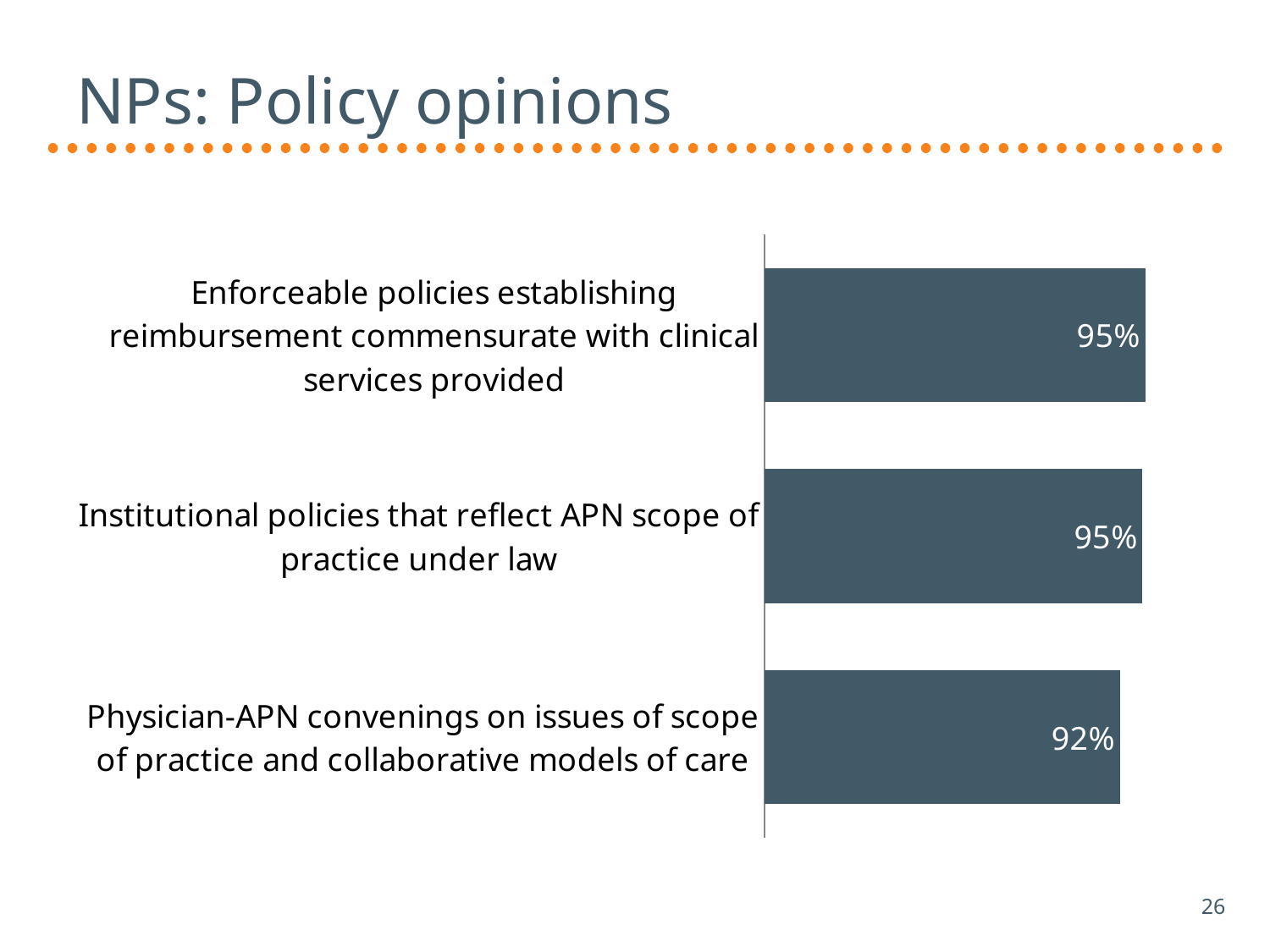
Are the bars on the chart horizontal or vertical? Horizontal What is the value for physician-APN convenings on issues of scope of practice and collaborative models of care? 92% What kind of chart is shown on the slide? Bar chart What percentage of NPs support enforceable policies establishing reimbursement commensurate with clinical services provided? 95% What is the value for institutional policies that reflect APN scope of practice under law? 95% Do the values decrease from the top bar to the bottom bar? No; the top two bars are equal at 95%, and only the bottom bar is lower at 92% What is the title of the slide? NPs: Policy opinions Which is larger: the value for enforceable reimbursement policies or the value for physician-APN convenings? Enforceable policies establishing reimbursement commensurate with clinical services provided Which policy option has the lowest value on the chart? Physician-APN convenings on issues of scope of practice and collaborative models of care How many policy options are shown on the chart? 3 What is the difference between the value for institutional policies that reflect APN scope of practice under law and the value for physician-APN convenings? 3%